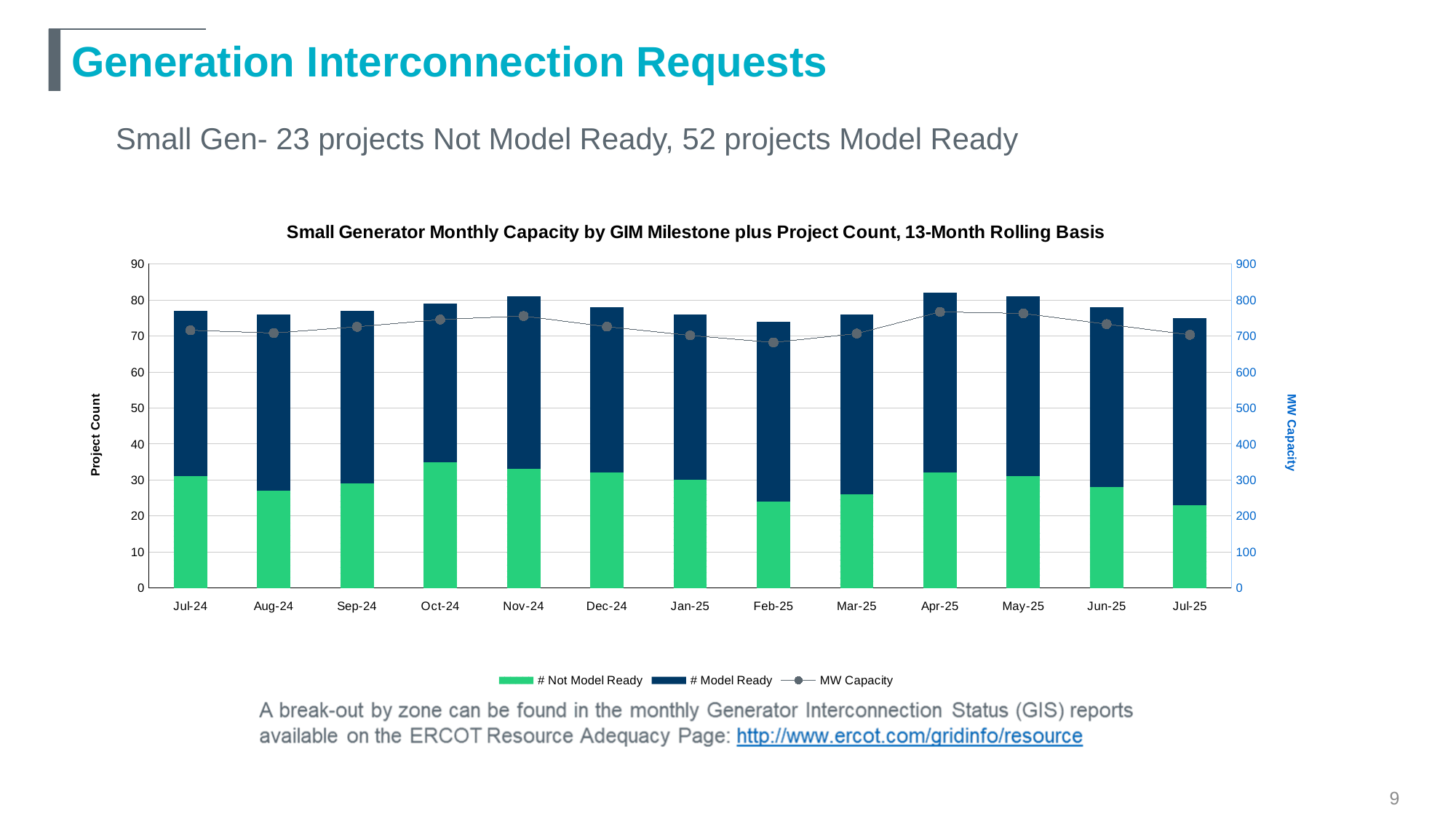
According to the slide, how many Small Gen projects are Not Model Ready? 23 Which month has the larger # Not Model Ready value, Oct-24 or Feb-25? Oct-24 Is the # Not Model Ready value for Feb-25 greater or less than 30? less What kind of chart is shown on the slide? Stacked bar chart with a line Is the total project count for Apr-25 greater or less than 80? greater How many months are shown on the x axis of the chart? 13 Is the # Not Model Ready value for Oct-24 greater or less than 30? greater Using the project counts stated on the slide, what is the total number of Small Gen projects (Not Model Ready plus Model Ready)? 75 According to the slide, how many Small Gen projects are Model Ready? 52 What is the label of the right-hand vertical axis? MW Capacity How many series does the chart legend list? 3